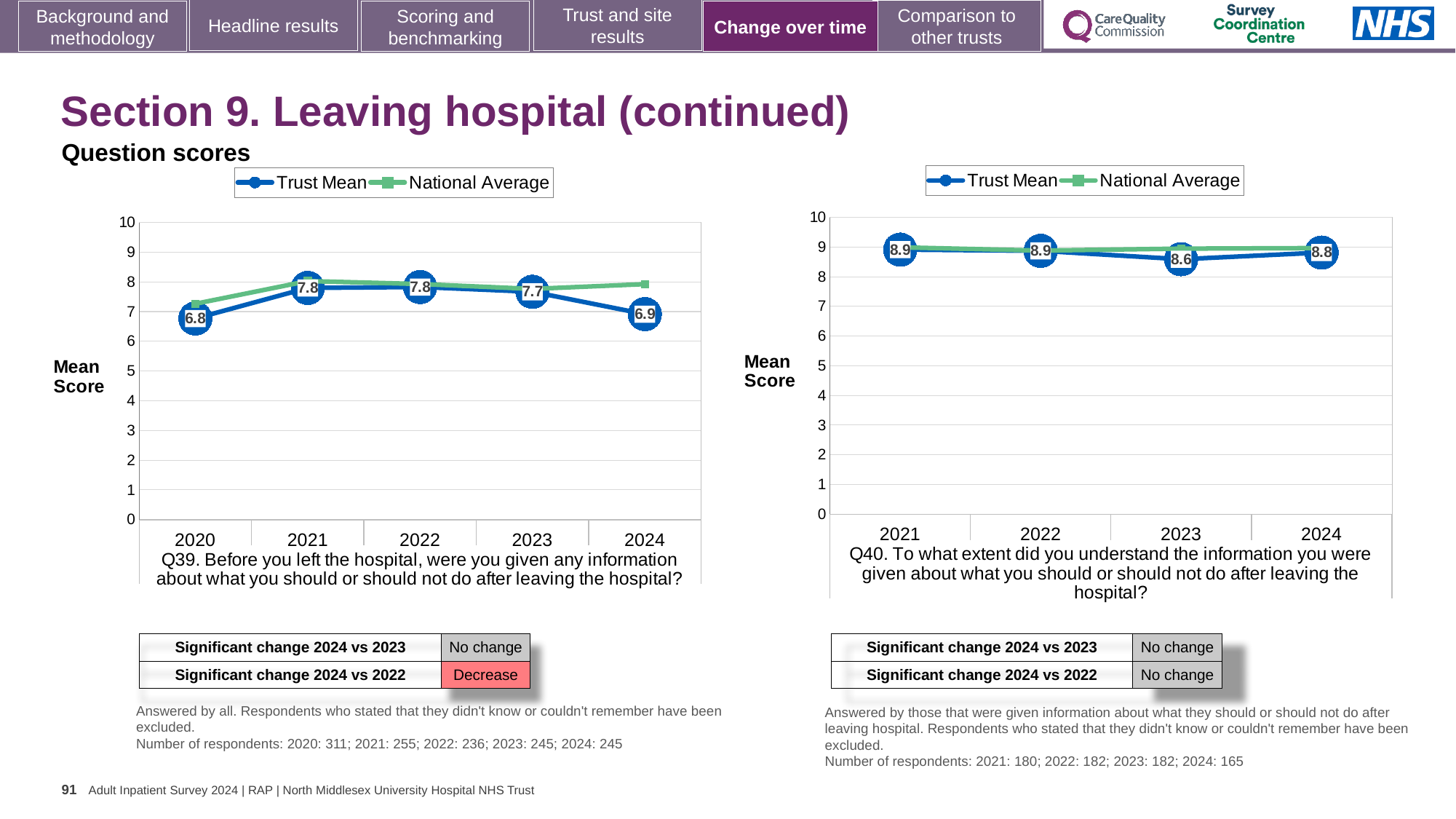
On the Q39 chart (left), how many years are shown on the x axis? 5 On the Q40 chart (right), is the Trust Mean score for 2021 or 2023 higher? 2021 On the Q40 chart (right), how many years are shown on the x axis? 4 On the Q39 chart (left), what is the Trust Mean score for 2024? 6.9 How many series does the legend of the Q40 chart (right) list? 2 On the Q40 chart (right), which year has the lowest Trust Mean score? 2023 On the Q39 chart (left), is the National Average value for 2024 greater or less than 7? greater What type of chart is the Q39 chart (left)? Line chart On the Q39 chart (left), what is the Trust Mean score for 2020? 6.8 On the Q39 chart (left), what is the difference between the Trust Mean scores for 2021 and 2024? 0.9 On the Q39 chart (left), which year has the lowest Trust Mean score? 2020 On the Q40 chart (right), what is the Trust Mean score for 2023? 8.6